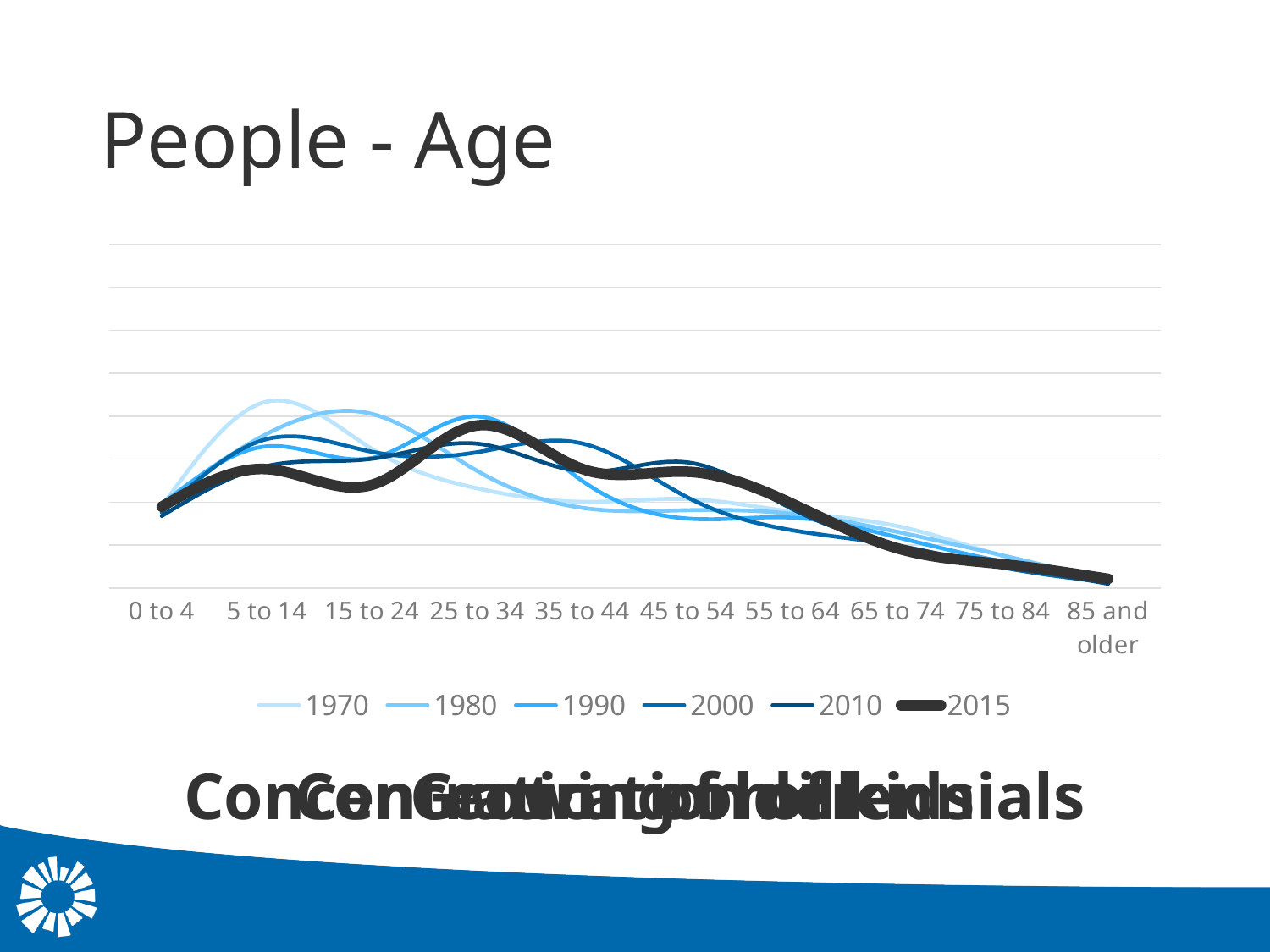
For the 2015 series, is the value for 25 to 34 larger or smaller than the value for 5 to 14? larger How many age categories are shown on the x axis? 10 For the 1970 series, which age category has the highest value? 5 to 14 For the 2015 series, which age category has the highest value? 25 to 34 What kind of chart is shown on the slide? line chart Which series is drawn with the thick dark grey line? 2015 For the 1970 series, do the values rise or fall from 5 to 14 through 85 and older? fall What is the title of the slide containing the chart? People - Age For the 2015 series, do the values rise or fall from 45 to 54 through 85 and older? fall How many series does the legend list? 6 For the 2015 series, which age category has the lowest value? 85 and older For the 1980 series, which age category has the highest value? 15 to 24